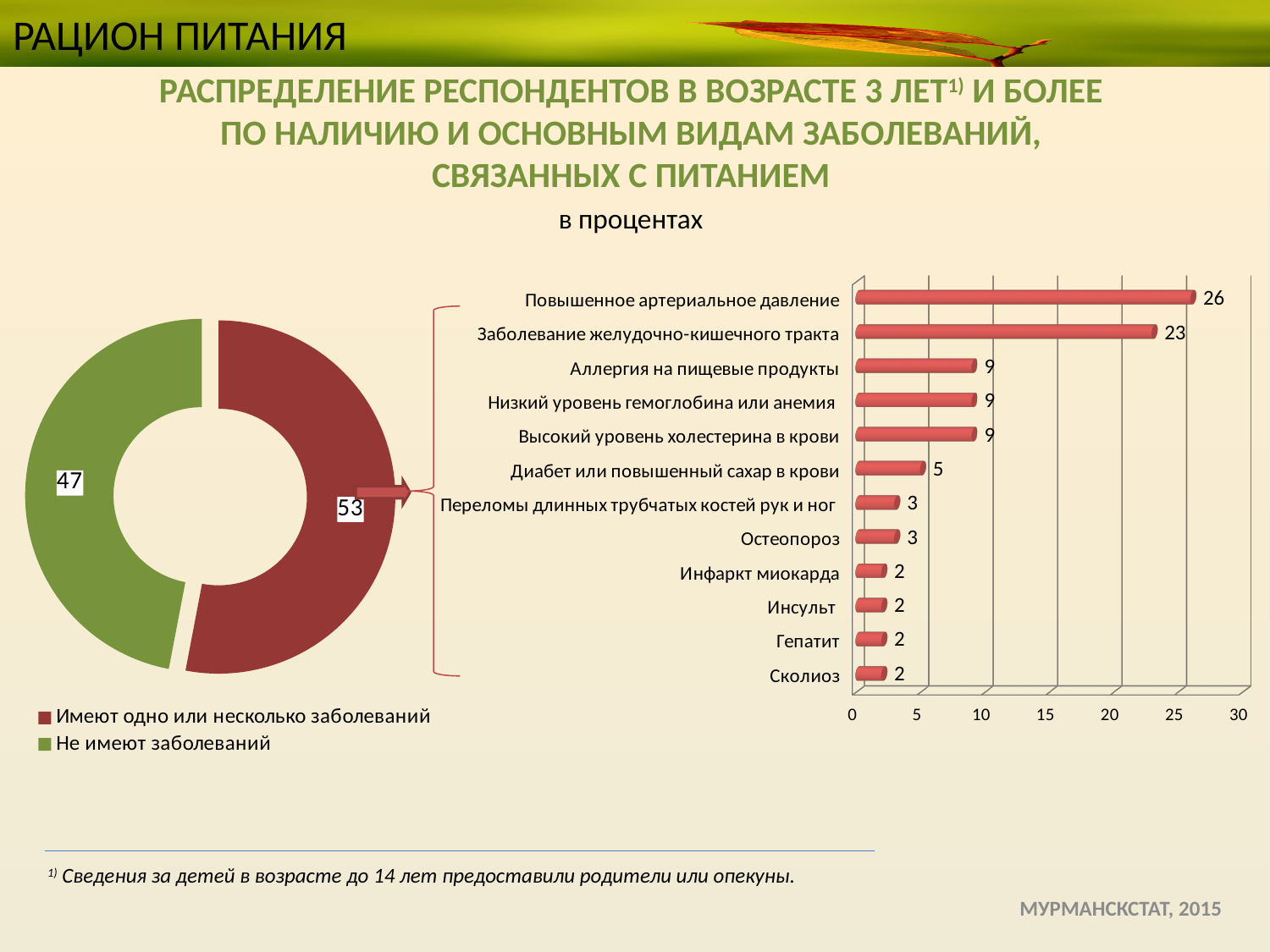
What type of chart is shown on the right side of the slide? Bar chart In the bar chart on the right, how many categories are shown? 12 In the doughnut chart on the left, which segment is larger: "Имеют одно или несколько заболеваний" or "Не имеют заболеваний"? Имеют одно или несколько заболеваний In the bar chart on the right, what is the value for "Заболевание желудочно-кишечного тракта"? 23 In the bar chart on the right, what is the value for "Повышенное артериальное давление"? 26 In the bar chart on the right, what is the difference between "Повышенное артериальное давление" and "Заболевание желудочно-кишечного тракта"? 3 In the doughnut chart on the left, how many entries does the legend list? 2 In the bar chart on the right, what is the value for "Диабет или повышенный сахар в крови"? 5 In the doughnut chart on the left, what is the value for "Имеют одно или несколько заболеваний"? 53 In the doughnut chart on the left, what is the value for "Не имеют заболеваний"? 47 In the bar chart on the right, is the value for "Аллергия на пищевые продукты" greater or less than 10? less In the bar chart on the right, which category has the highest value? Повышенное артериальное давление